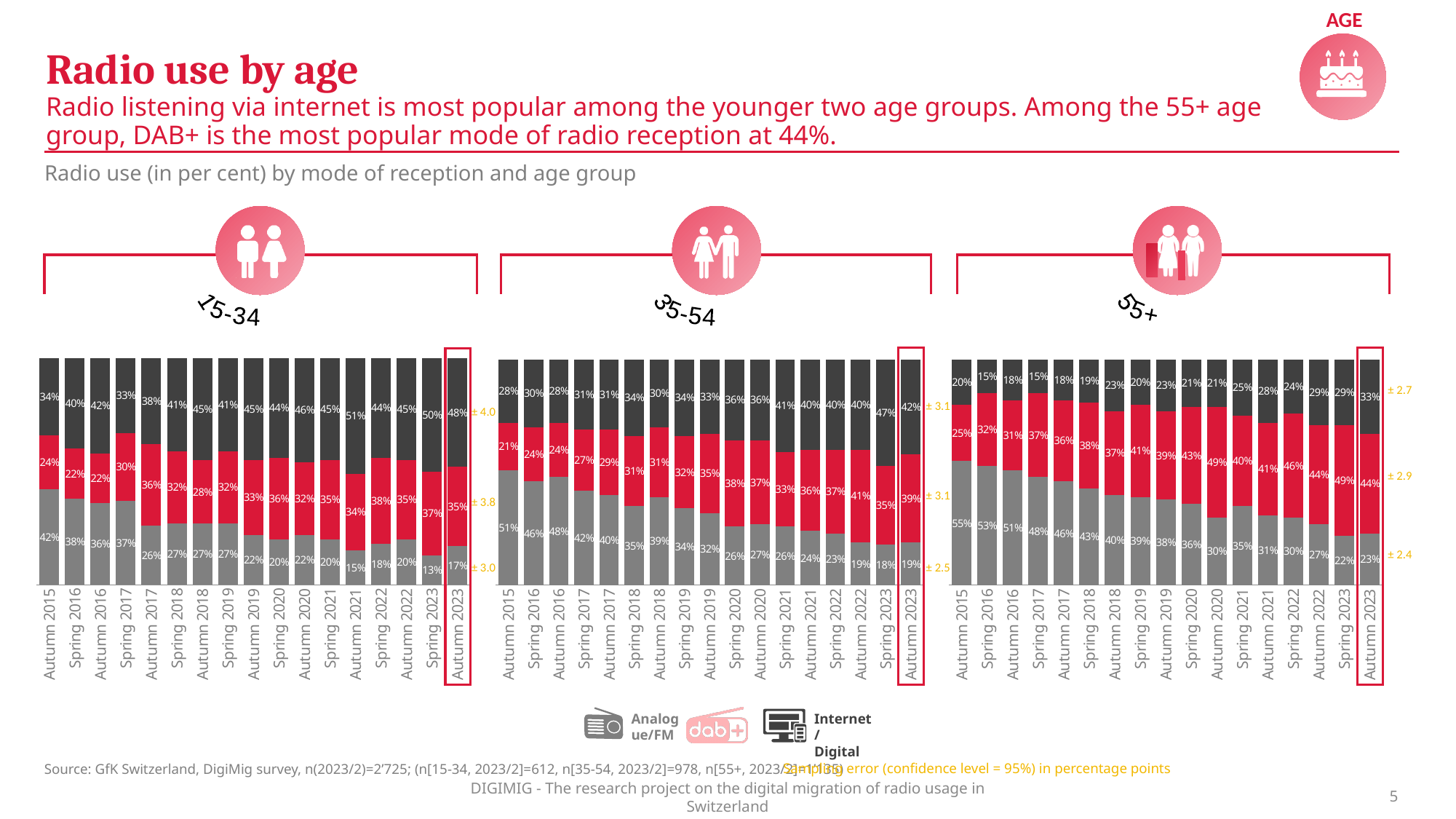
In the 55+ chart, what is the difference between the Analogue/FM values for Autumn 2015 and Autumn 2023? 32 percentage points In the 15-34 chart, what is the Internet/Digital value for Autumn 2023? 48% In the 35-54 chart, what is the Analogue/FM value for Autumn 2015? 51% In the 55+ chart, does the Analogue/FM value rise or fall from Autumn 2015 to Autumn 2023? Fall In the 15-34 chart, which period has the lowest Analogue/FM value? Spring 2023 What kind of chart is used for the 35-54 age group? Stacked bar chart In the 55+ chart, which period has the highest Analogue/FM value? Autumn 2015 How many series does the legend list? 3 How many periods (bars) are shown in the 15-34 chart? 17 In the 35-54 chart, which is larger for Autumn 2023: the DAB+ value or the Analogue/FM value? DAB+ In the 55+ chart, what is the DAB+ value for Autumn 2023? 44% Which mode of reception is shown in red in the charts? DAB+